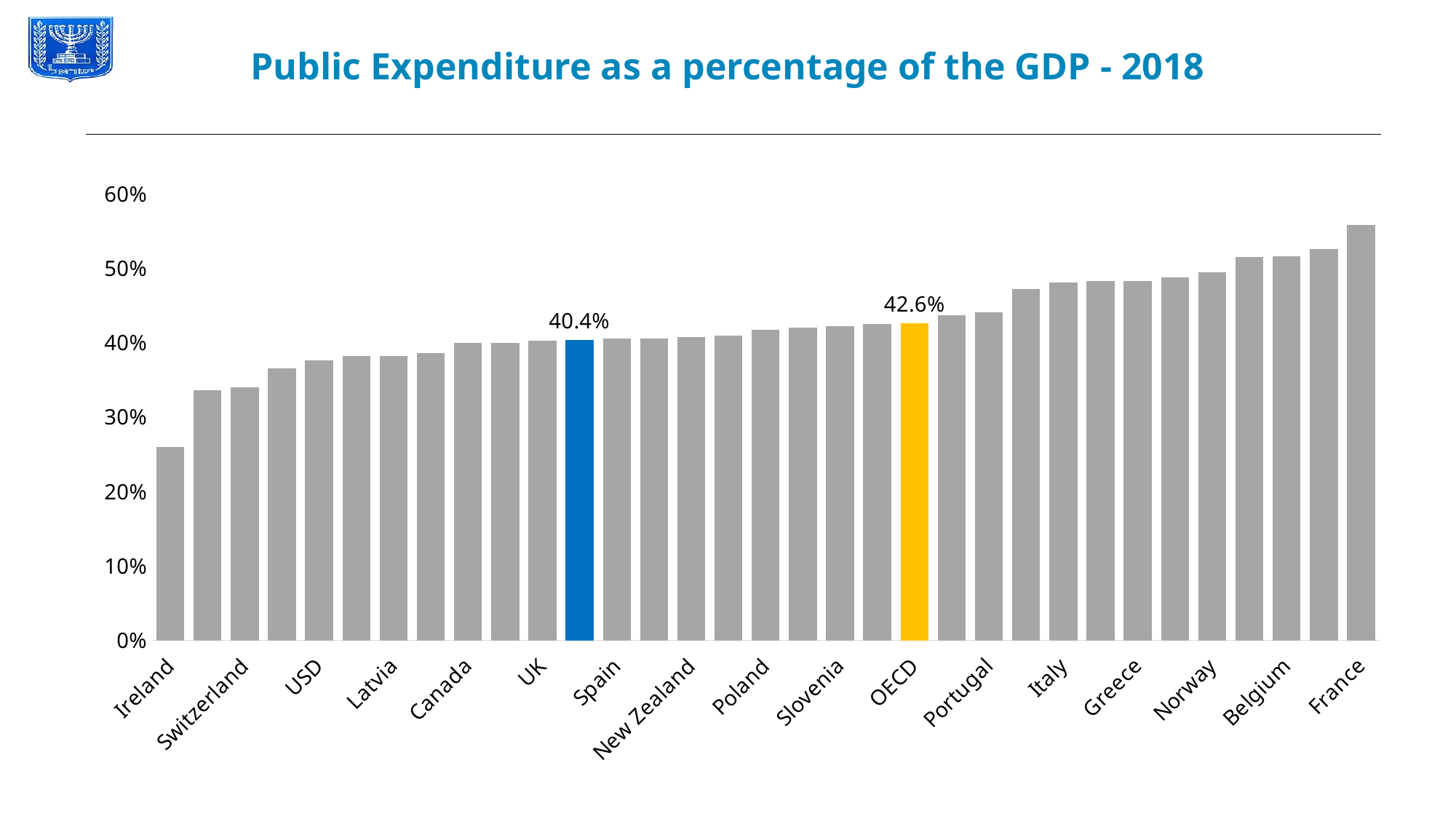
What kind of chart is shown on the slide? Bar chart Which labelled country has the lowest public expenditure as a percentage of GDP? Ireland What value is printed above the blue bar? 40.4% What is the difference between the OECD value and the value printed on the blue bar? 2.2 percentage points Which labelled country has the highest public expenditure as a percentage of GDP? France Is the value for Switzerland greater or less than 40%? less Do the bar values rise or fall from left to right along the x axis? Rise What is the value shown for OECD? 42.6% Which is higher, Belgium or Italy? Belgium Is the value for France greater or less than 50%? greater Is the value for Ireland greater or less than 30%? less What colour is the OECD bar? Yellow